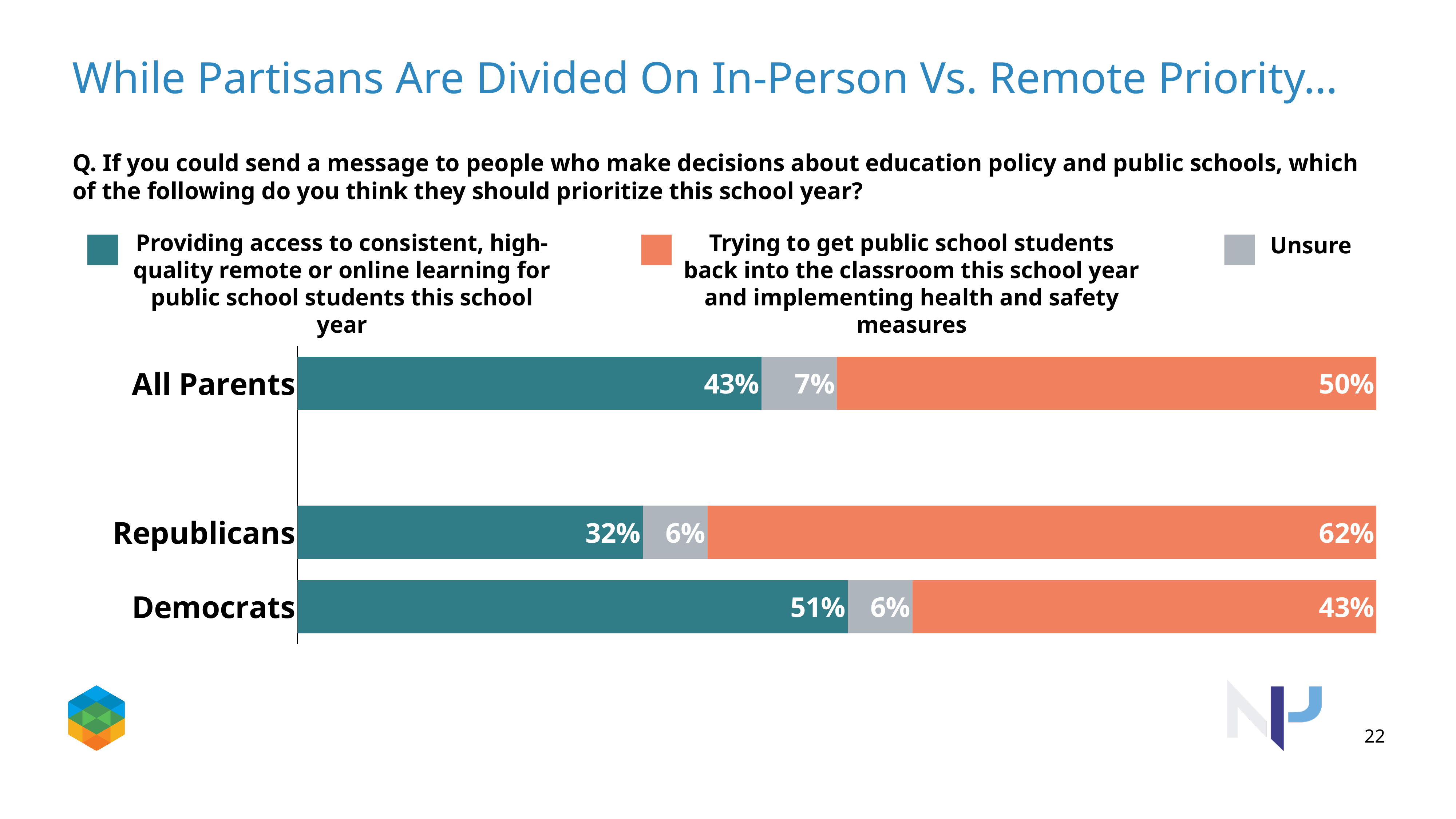
How many groups are shown on the chart? 3 What kind of chart is shown on the slide? Stacked bar chart How many series does the legend list? 3 What percentage of All Parents chose providing access to consistent, high-quality remote or online learning? 43% What is the difference between the Republicans' and Democrats' percentages for getting students back into the classroom? 19% What percentage of Democrats are Unsure? 6% What colour represents the Unsure series? Gray Which is larger: the Democrats' percentage for remote or online learning or the All Parents' percentage for remote or online learning? Democrats Which group has the highest percentage choosing to get students back into the classroom? Republicans What is the total of the stacked bar for All Parents? 100% What percentage of Republicans chose trying to get public school students back into the classroom? 62% Which group has the lowest percentage choosing remote or online learning? Republicans